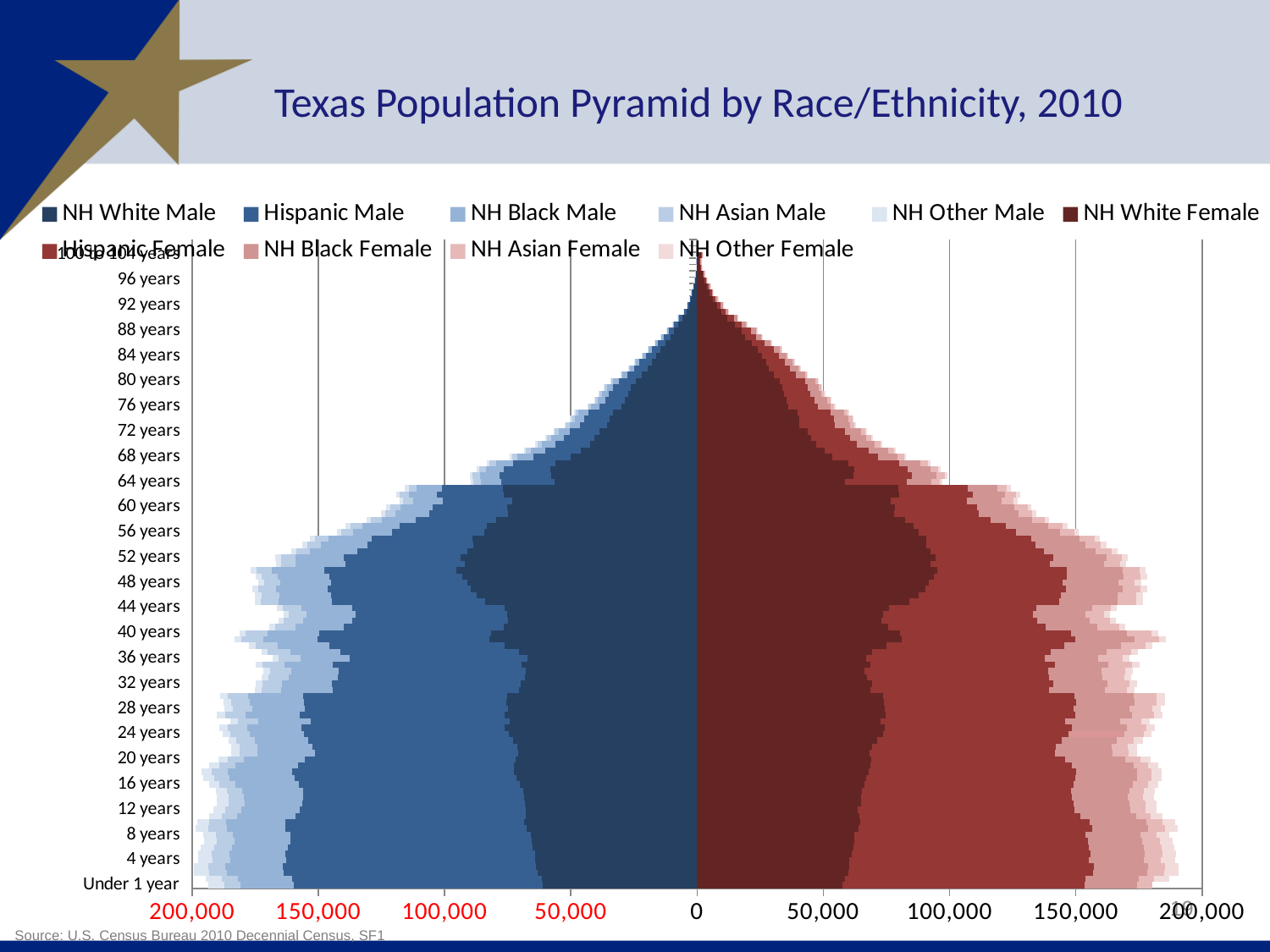
Is the total female population for 76 years greater or less than 100,000? less How many series does the legend list? 10 Is the total male population for 96 years greater or less than 50,000? less Is the total female population for Under 1 year greater or less than 150,000? greater Which legend entry is shown in the darkest blue colour? NH White Male Which has the larger total male population, Under 1 year or 64 years? Under 1 year What kind of chart is shown on the slide? bar chart Do the total bar lengths generally rise or fall as age increases from Under 1 year to 100 to 104 years? fall What is the title of the chart? Texas Population Pyramid by Race/Ethnicity, 2010